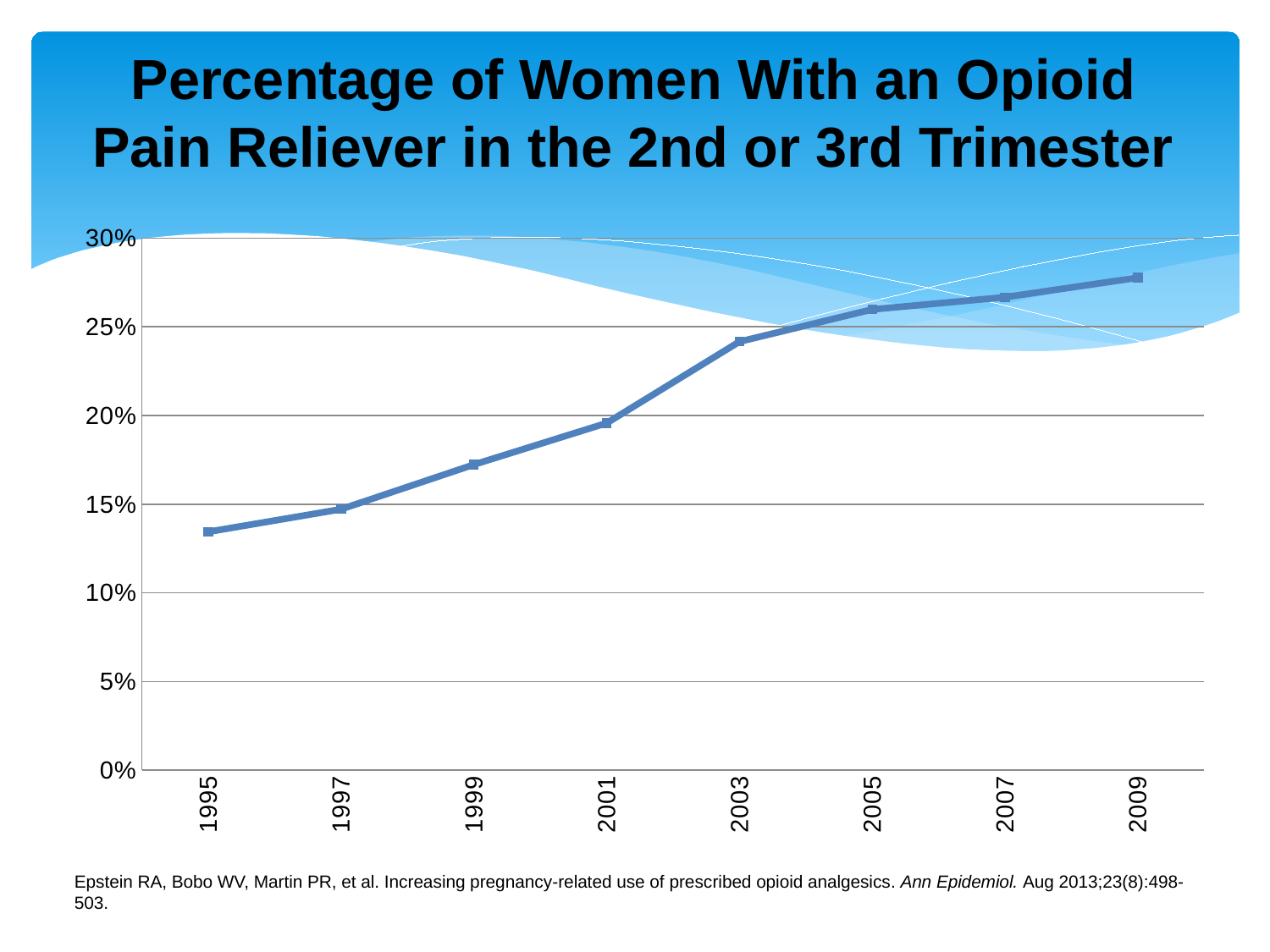
Is the value for 2003 greater or less than 25%? less Is the value for 2005 greater or less than 25%? greater What is the title of the chart? Percentage of Women With an Opioid Pain Reliever in the 2nd or 3rd Trimester Which year has the lowest percentage of women with an opioid pain reliever in the 2nd or 3rd trimester? 1995 Which is larger, the value for 2001 or the value for 2003? 2003 Is the value for 1999 greater or less than 15%? greater Do the values rise or fall from 1995 to 2009? rise What kind of chart is shown on the slide? line chart Which year has the highest percentage of women with an opioid pain reliever in the 2nd or 3rd trimester? 2009 How many years are plotted on the x axis? 8